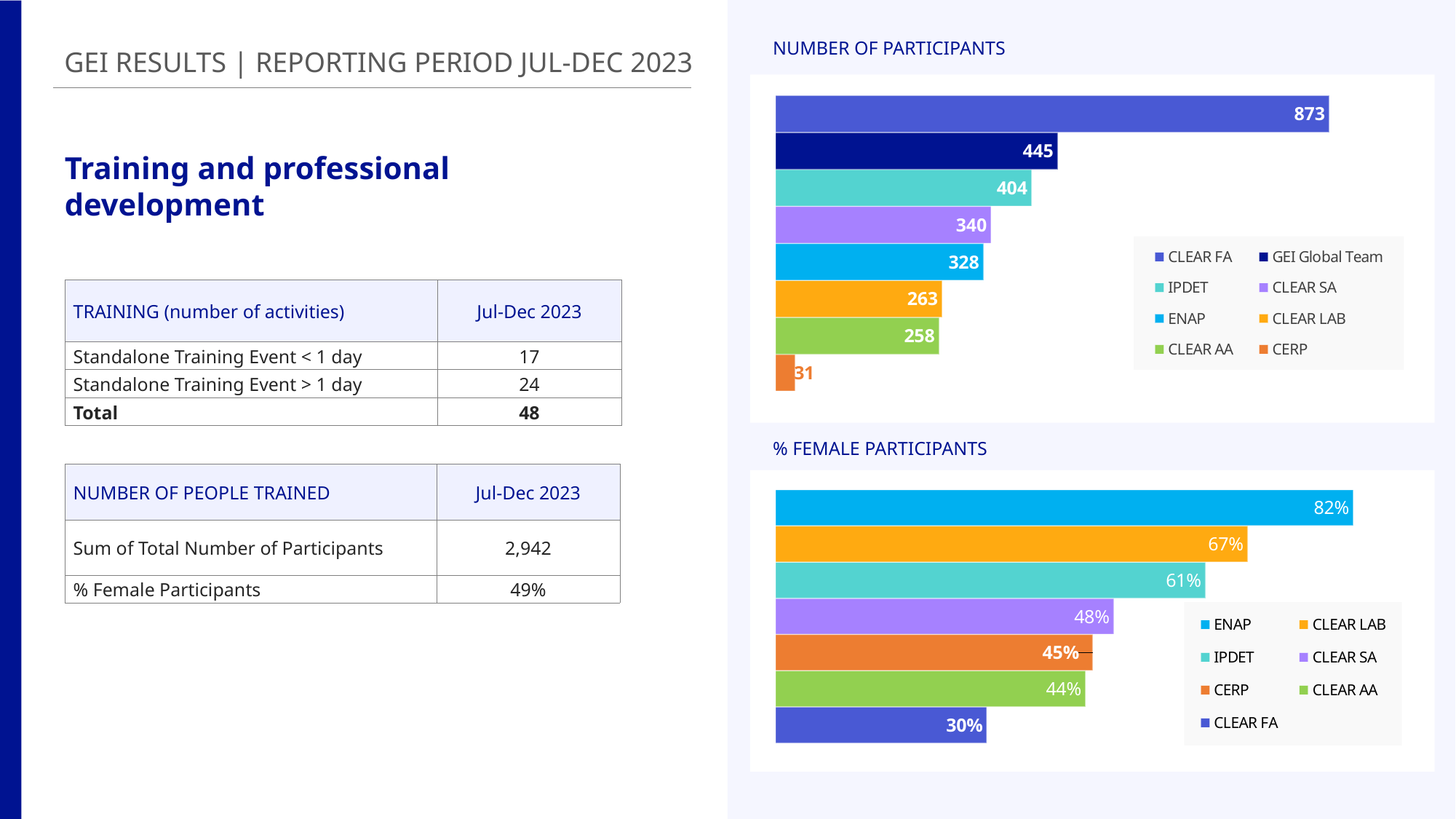
In the % FEMALE PARTICIPANTS chart, what is the value for ENAP? 82% In the NUMBER OF PARTICIPANTS chart, what is the difference between the values for GEI Global Team and ENAP? 117 In the % FEMALE PARTICIPANTS chart, how many entries does the legend list? 7 In the NUMBER OF PARTICIPANTS chart, what is the value for IPDET? 404 In the NUMBER OF PARTICIPANTS chart, which is larger, CLEAR LAB or CLEAR AA? CLEAR LAB What type of chart is the % FEMALE PARTICIPANTS chart? Bar chart In the % FEMALE PARTICIPANTS chart, what is the difference between CLEAR LAB and CLEAR SA? 19% In the % FEMALE PARTICIPANTS chart, which category has the lowest percentage? CLEAR FA In the NUMBER OF PARTICIPANTS chart, which category has the lowest number of participants? CERP In the NUMBER OF PARTICIPANTS chart, how many bars are plotted? 8 In the NUMBER OF PARTICIPANTS chart, which category has the highest number of participants? CLEAR FA In the NUMBER OF PARTICIPANTS chart, how many participants does CLEAR FA have? 873